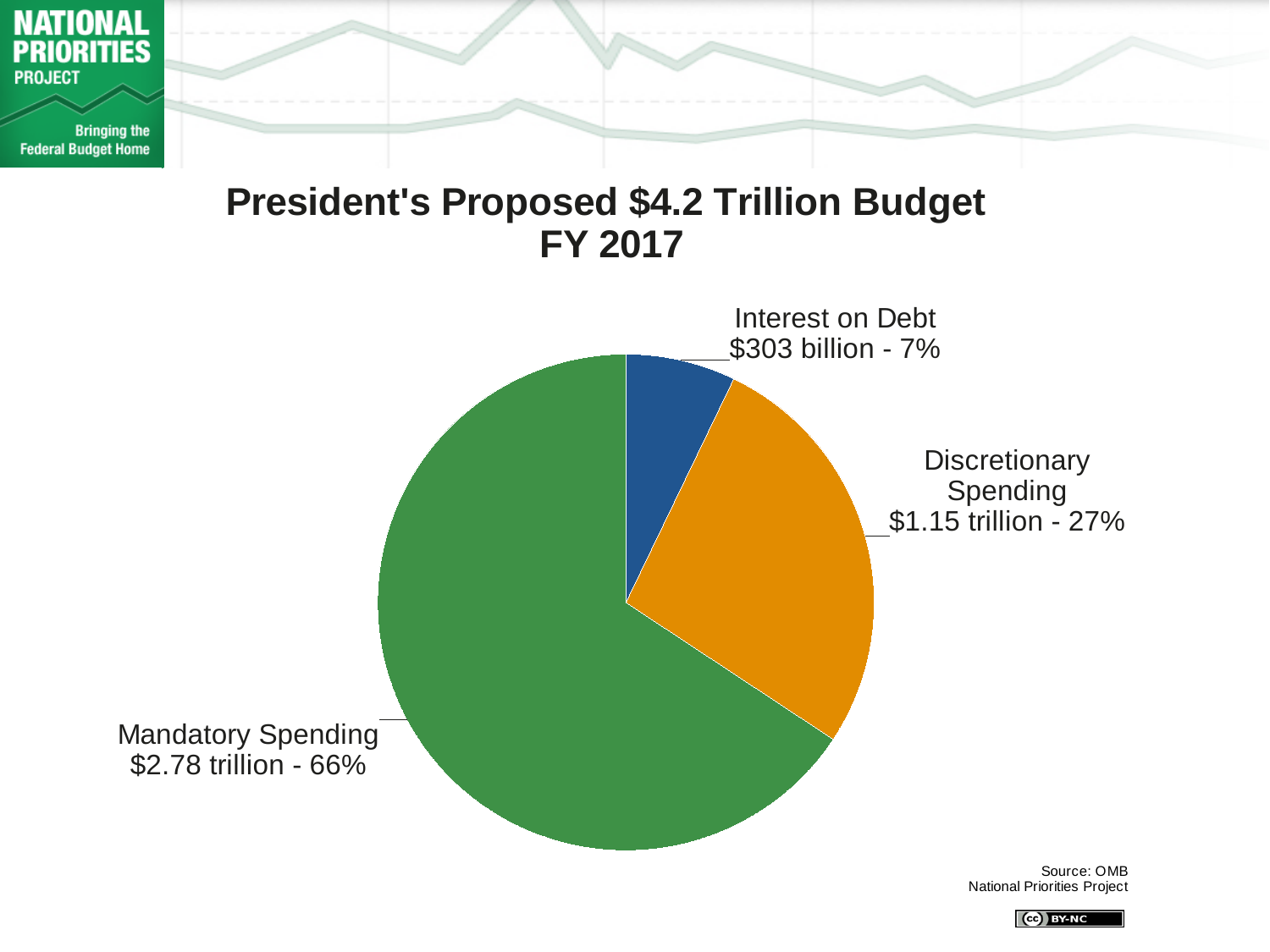
Which is larger, the share for Discretionary Spending or the share for Interest on Debt? Discretionary Spending What share of the pie does Interest on Debt represent? 7% Which category has the smallest slice of the pie? Interest on Debt What share of the pie does Discretionary Spending represent? 27% What is the dollar value shown for Discretionary Spending? $1.15 trillion What is the dollar value shown for Mandatory Spending? $2.78 trillion How many slices does the pie chart have? 3 Which category has the largest slice of the pie? Mandatory Spending What kind of chart is shown on the slide? pie chart What is the title of the chart? President's Proposed $4.2 Trillion Budget FY 2017 What is the dollar value shown for Interest on Debt? $303 billion What share of the pie does Mandatory Spending represent? 66%